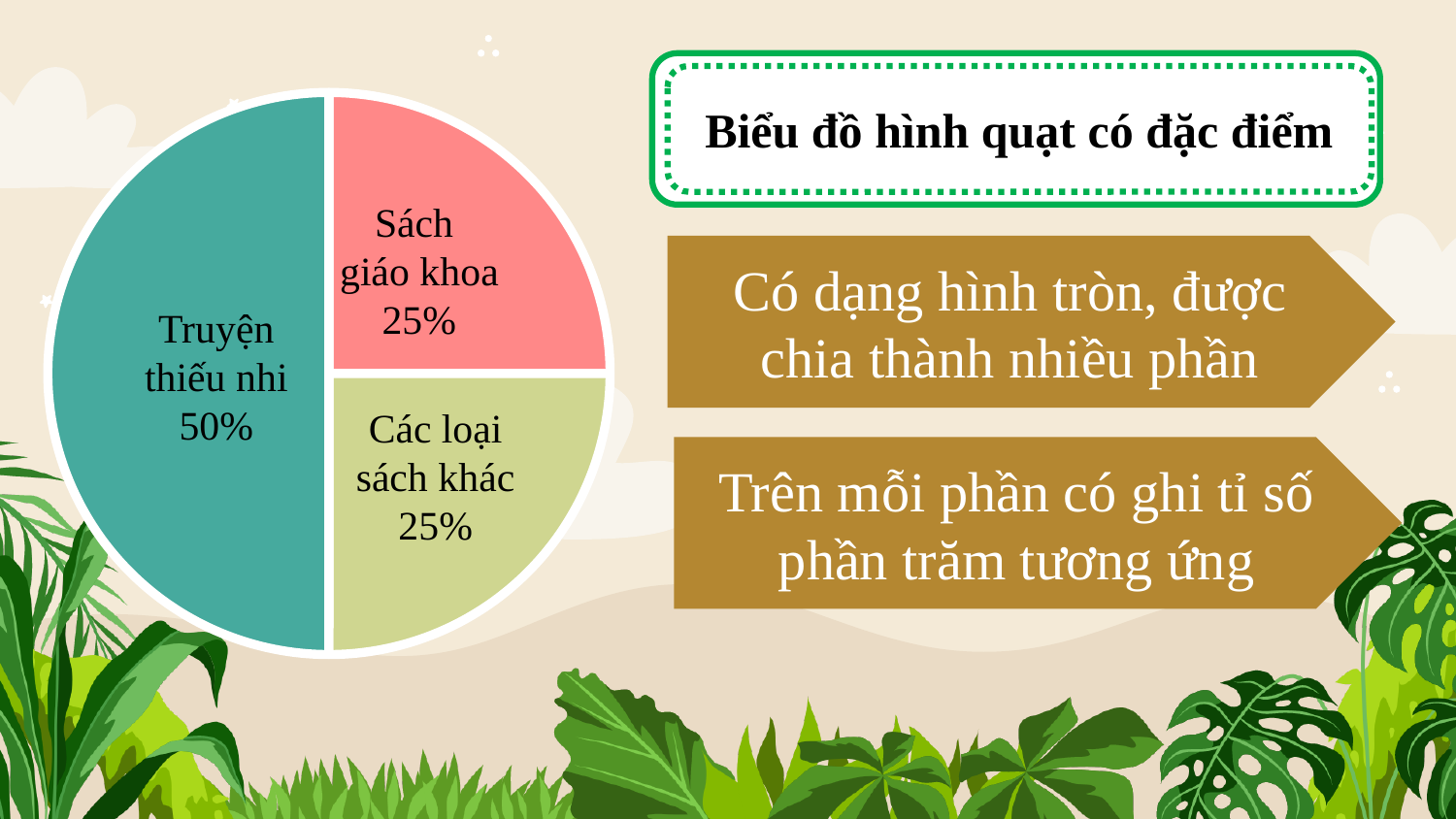
What kind of chart is shown on the slide? pie chart Which slice of the pie chart is coloured teal (blue-green)? Truyện thiếu nhi What is the difference in percentage points between Truyện thiếu nhi and Các loại sách khác? 25 What percentage is shown for Sách giáo khoa? 25% Which is larger, the slice for Truyện thiếu nhi or the slice for Sách giáo khoa? Truyện thiếu nhi What share of the pie does Sách giáo khoa take? 25% Which slice of the pie chart is the largest? Truyện thiếu nhi Which slice of the pie chart is coloured pink/red? Sách giáo khoa How many slices does the pie chart have? 3 What percentage is shown for Truyện thiếu nhi? 50% What percentage is shown for Các loại sách khác? 25% What do the slices for Sách giáo khoa and Các loại sách khác add up to? 50%